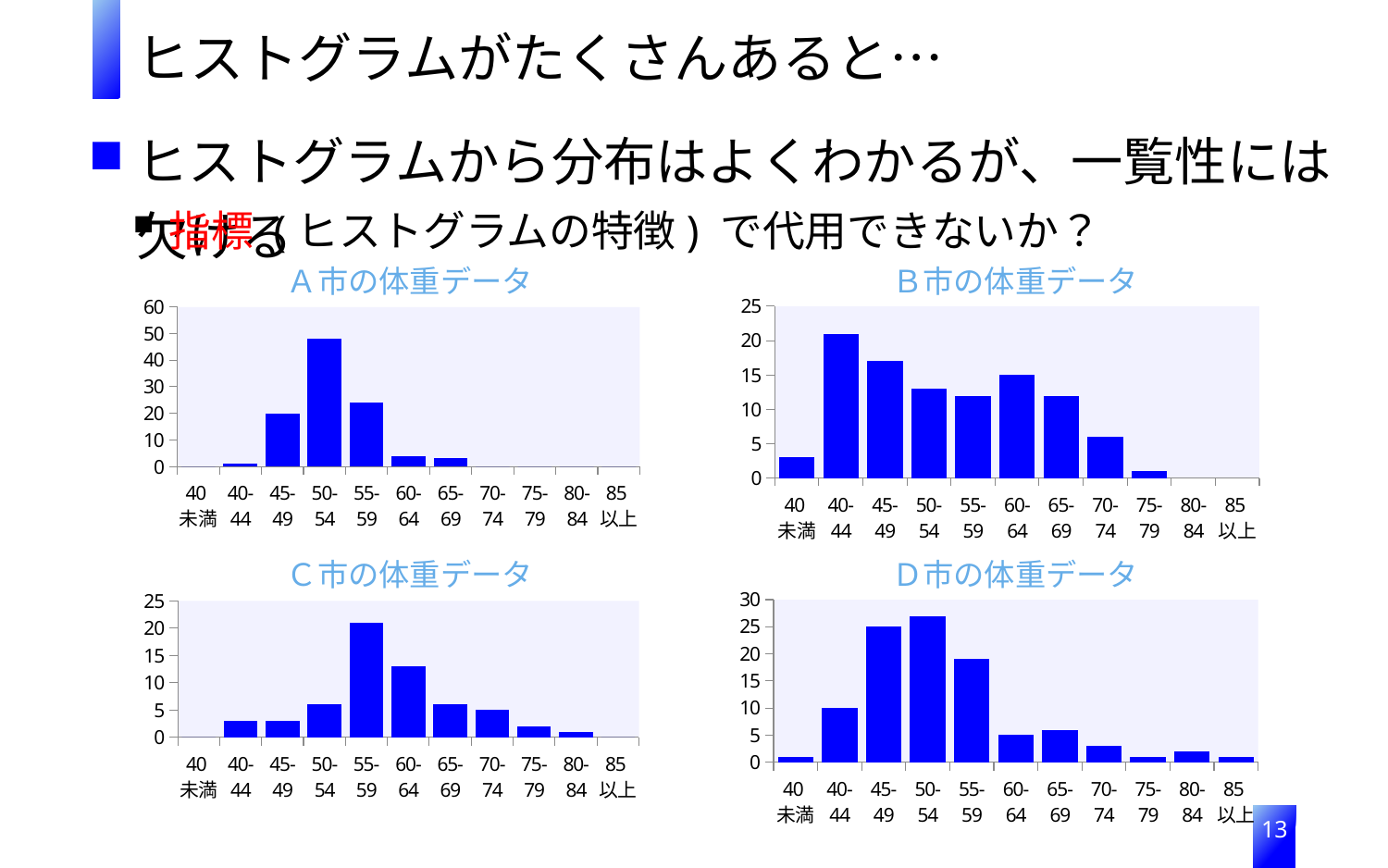
In the D市の体重データ chart, which weight category has the highest bar? 50-54 In the A市の体重データ chart, is the value for 50-54 greater or less than 40? greater In the D市の体重データ chart, which is larger, the value for 45-49 or the value for 55-59? 45-49 In the A市の体重データ chart, is the value for 60-64 greater or less than 10? less In the B市の体重データ chart, is the value for 40-44 greater or less than 20? greater In the B市の体重データ chart, which is larger, the value for 40-44 or the value for 45-49? 40-44 In the A市の体重データ chart, which weight category has the highest bar? 50-54 In the B市の体重データ chart, which weight category has the highest bar? 40-44 What kind of chart is the A市の体重データ chart? bar chart How many weight categories are shown on the x axis of the D市の体重データ chart? 11